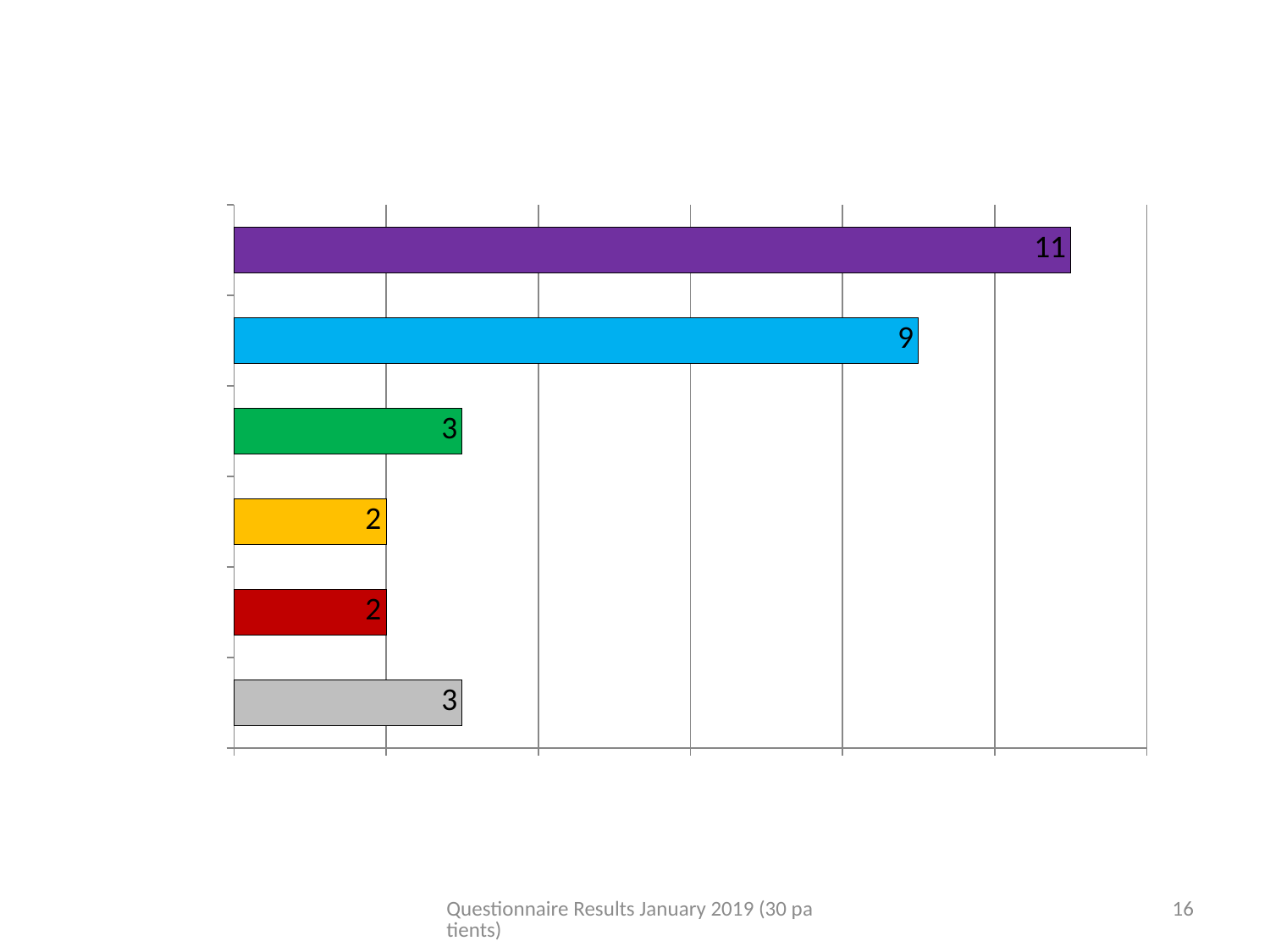
What is the value of the grey bar at the bottom of the chart? 3 What is the difference between the purple bar and the light blue bar? 2 What is the value of the purple bar at the top of the chart? 11 What is the value of the light blue bar, the second from the top? 9 What kind of chart is shown on the slide? bar chart Which bar has the highest value? the purple bar (top) What is the value of the red bar? 2 How many bars does the chart show? 6 Which is larger, the green bar or the yellow bar? the green bar What is the value of the green bar? 3 What is the total of all six bar values? 30 What is the value of the yellow bar? 2